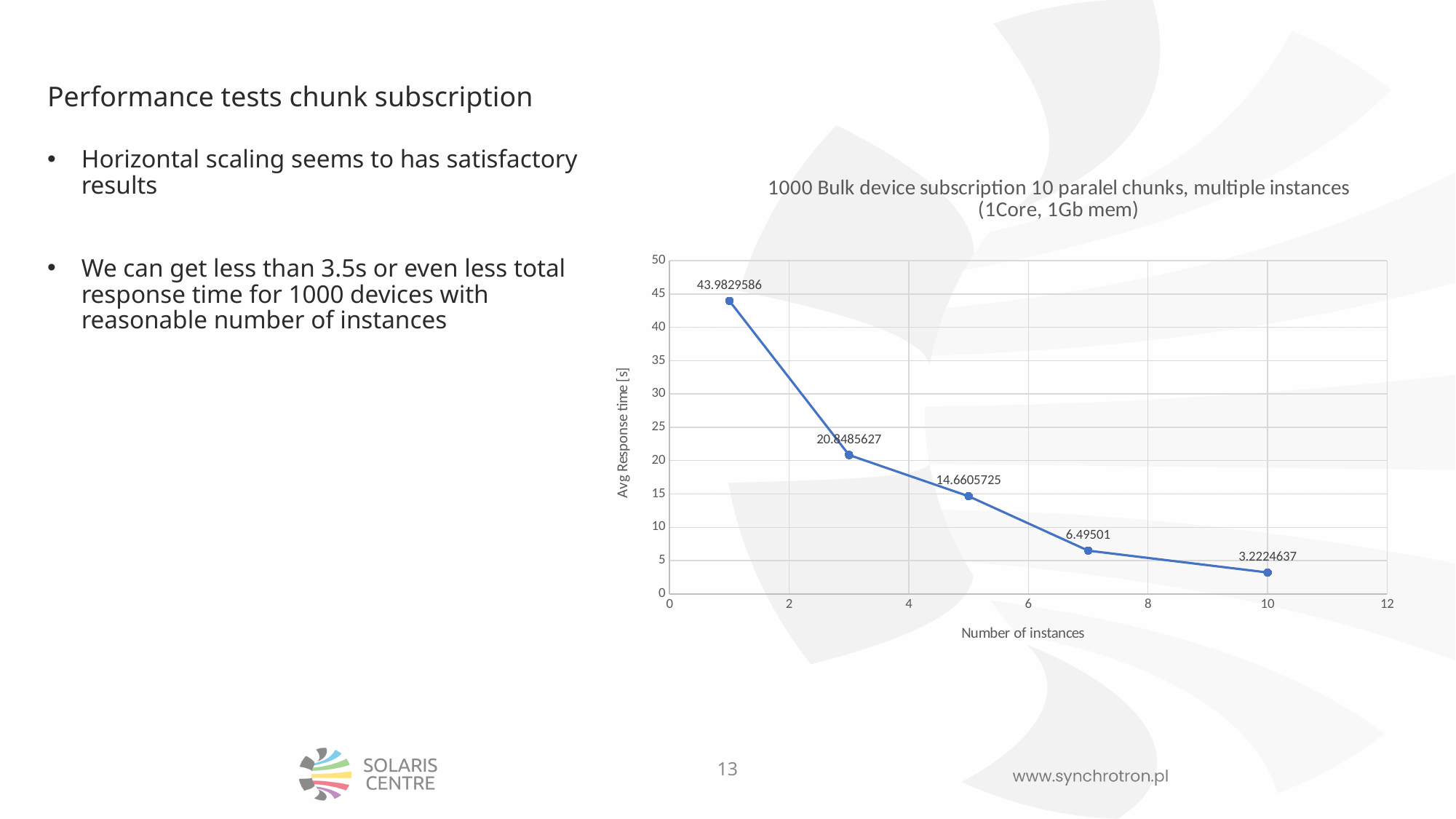
What is the average response time for 3 instances? 20.8485627 What kind of chart is shown on the slide? Line chart How many data points are plotted on the chart? 5 What is the average response time for 10 instances? 3.2224637 What is the average response time for 7 instances? 6.49501 At which number of instances is the average response time lowest? 10 What is the difference in average response time between 1 instance and 10 instances? 40.7604949 Does the average response time rise or fall as the number of instances increases? Fall Which has a larger average response time: 3 instances or 7 instances? 3 instances At which number of instances is the average response time highest? 1 What is the average response time for 1 instance? 43.9829586 What is the average response time for 5 instances? 14.6605725